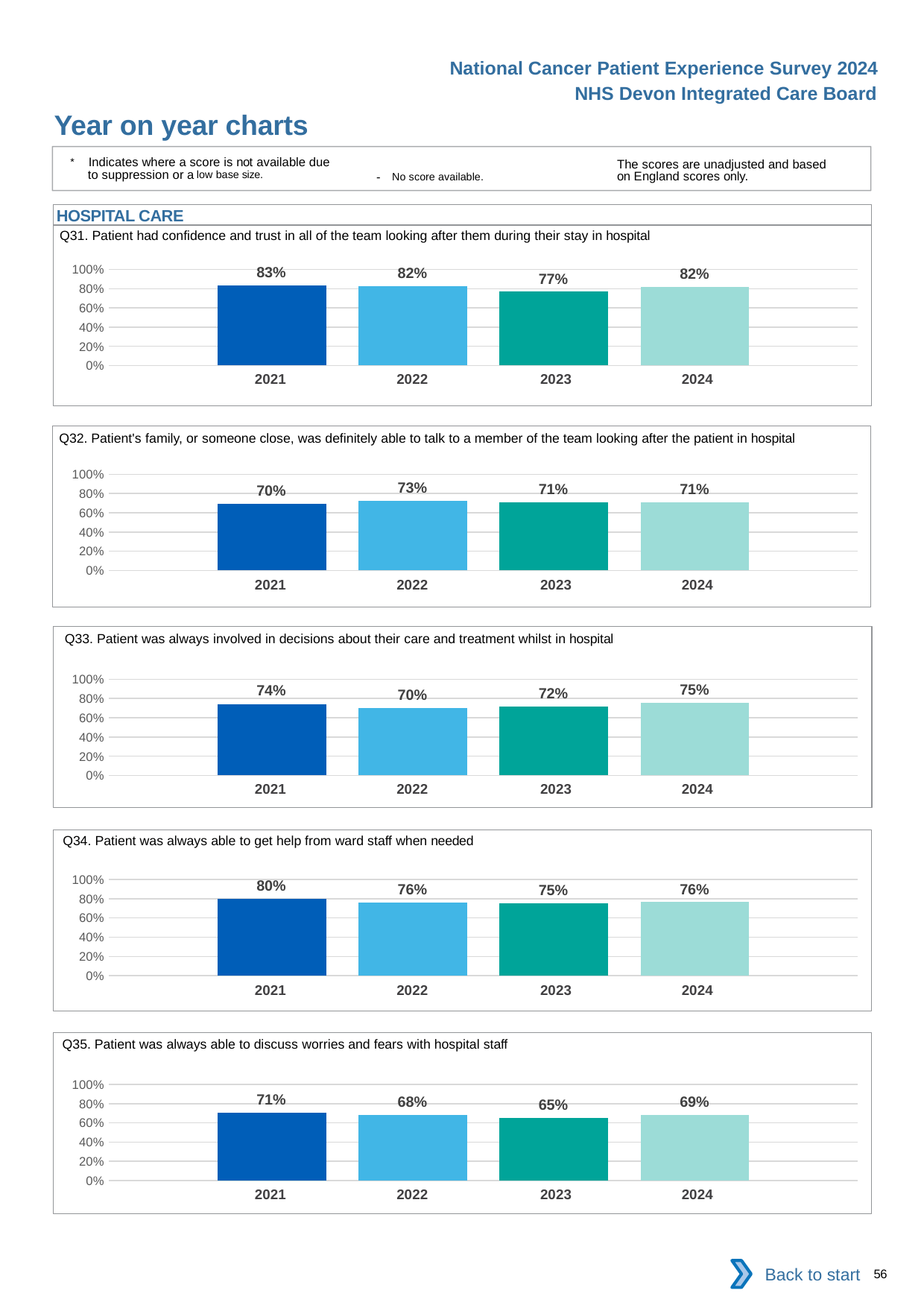
In the Q32 chart, which year has the lowest value? 2021 What type of chart is used for Q31? Bar chart In the Q33 chart, which year has the highest value? 2024 In the Q31 chart, which year has the highest value? 2021 How many years are shown on the x axis of the Q35 chart? 4 In the Q31 chart, what is the value for 2023? 77% In the Q35 chart, which year has the lowest value? 2023 In the Q34 chart, is the value for 2021 larger or smaller than the value for 2023? larger In the Q34 chart, what is the value for 2021? 80% In the Q33 chart, what is the difference between the 2024 value and the 2022 value? 5% In the Q32 chart, what is the value for 2022? 73% In the Q35 chart, what is the difference between the 2021 value and the 2023 value? 6%